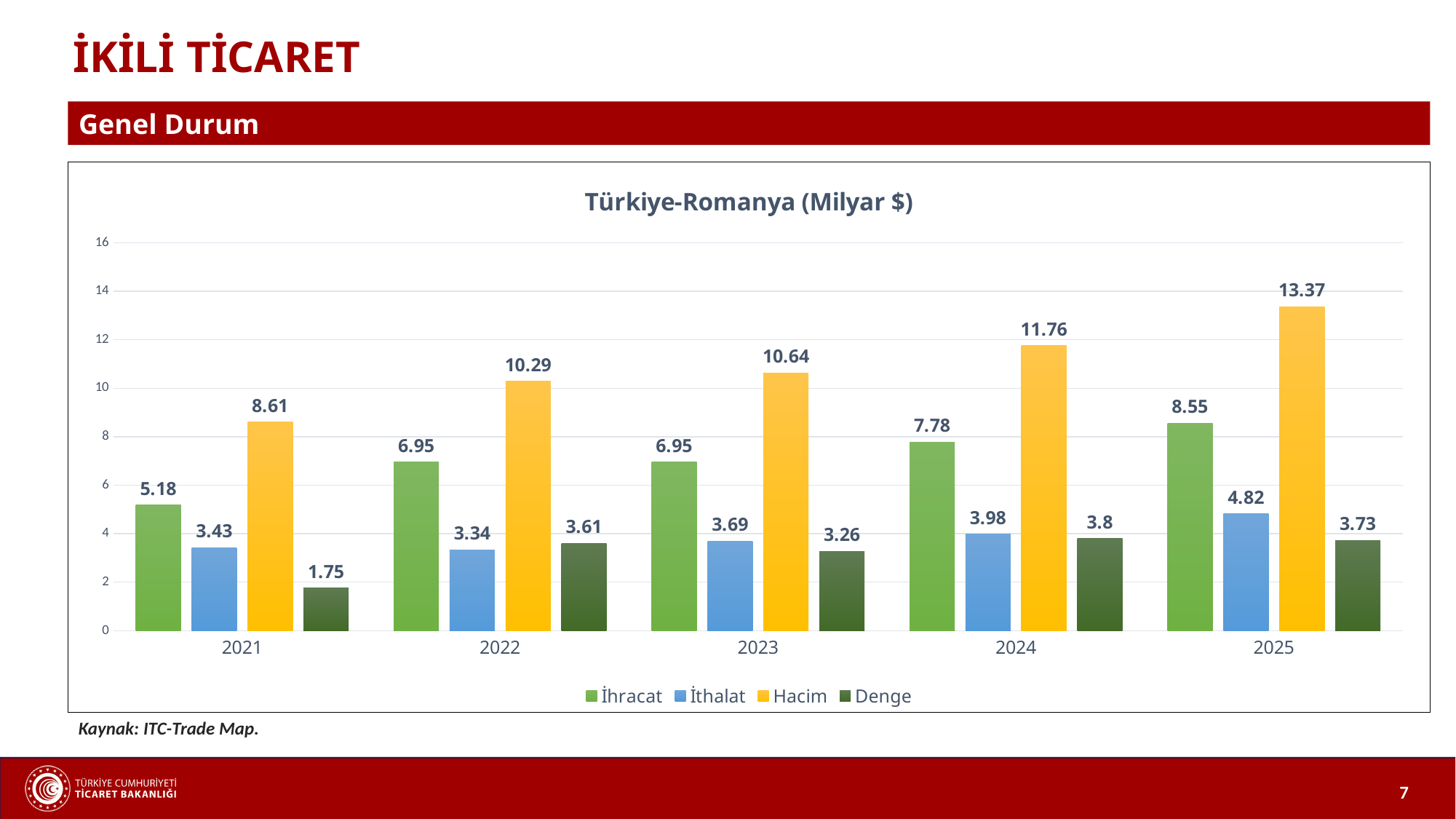
How many years are shown on the x axis? 5 Does the Hacim value rise or fall from 2021 to 2025? rise What is the İhracat value for 2021? 5.18 What is the İthalat value for 2023? 3.69 What is the Denge value for 2024? 3.8 What is the difference between the Hacim values for 2025 and 2024? 1.61 In which year is the Hacim value highest? 2025 How many series does the legend list? 4 What is the Hacim value for 2025? 13.37 What kind of chart is shown on the slide? bar chart In which year is the Denge value lowest? 2021 Which is larger, the İthalat value for 2022 or the İthalat value for 2025? 2025